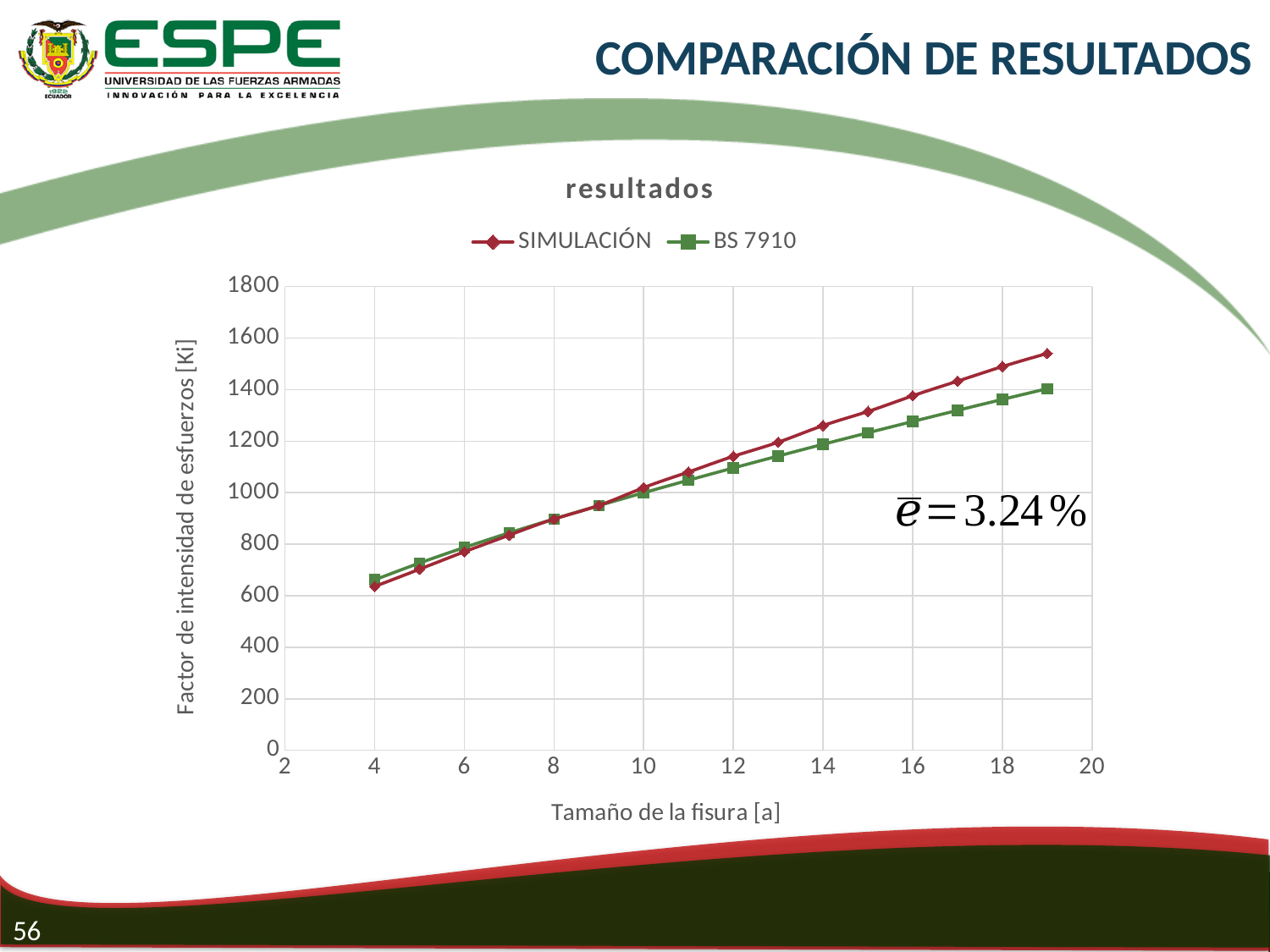
What are the two series named in the legend? SIMULACIÓN and BS 7910 Is the value of the SIMULACIÓN series at crack size 12 greater or less than 1000? greater Is the value of the SIMULACIÓN series at crack size 19 greater or less than 1400? greater Is the value of the BS 7910 series at crack size 4 greater or less than 600? greater What kind of chart is shown on the slide? line chart Do the values of the SIMULACIÓN series rise or fall as the crack size increases along the x axis? rise Which series reaches the highest value on the chart? SIMULACIÓN At crack size 4, which series has the higher value, SIMULACIÓN or BS 7910? BS 7910 What is the label of the x axis? Tamaño de la fisura [a] At crack size 19, which series has the higher value, SIMULACIÓN or BS 7910? SIMULACIÓN How many series does the legend list? 2